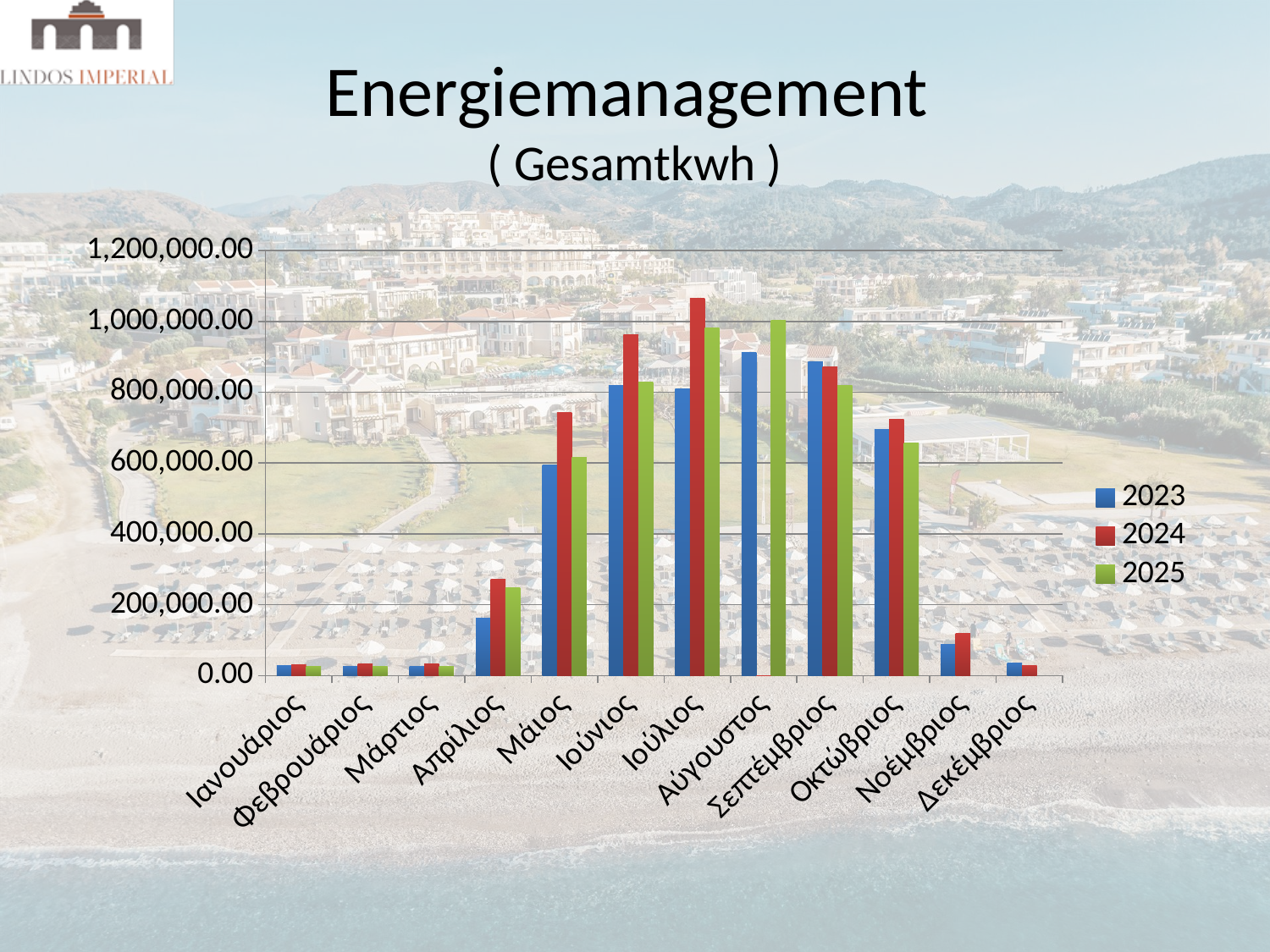
For Αύγουστος, which series has the larger value, 2023 or 2025? 2025 Is the 2024 value for Απρίλιος greater or less than 200,000.00? greater Is the 2023 value for Ιανουάριος greater or less than 200,000.00? less Is the 2024 value for Μάιος greater or less than 600,000.00? greater Which month has the highest value for the 2024 series? Ιούλιος How many series does the legend list? 3 How many months (categories) are shown on the x axis? 12 What kind of chart is shown on the slide? bar chart Which month has the highest value for the 2025 series? Αύγουστος For Ιούνιος, which series has the larger value, 2023 or 2024? 2024 What are the legend entries of the chart? 2023, 2024, 2025